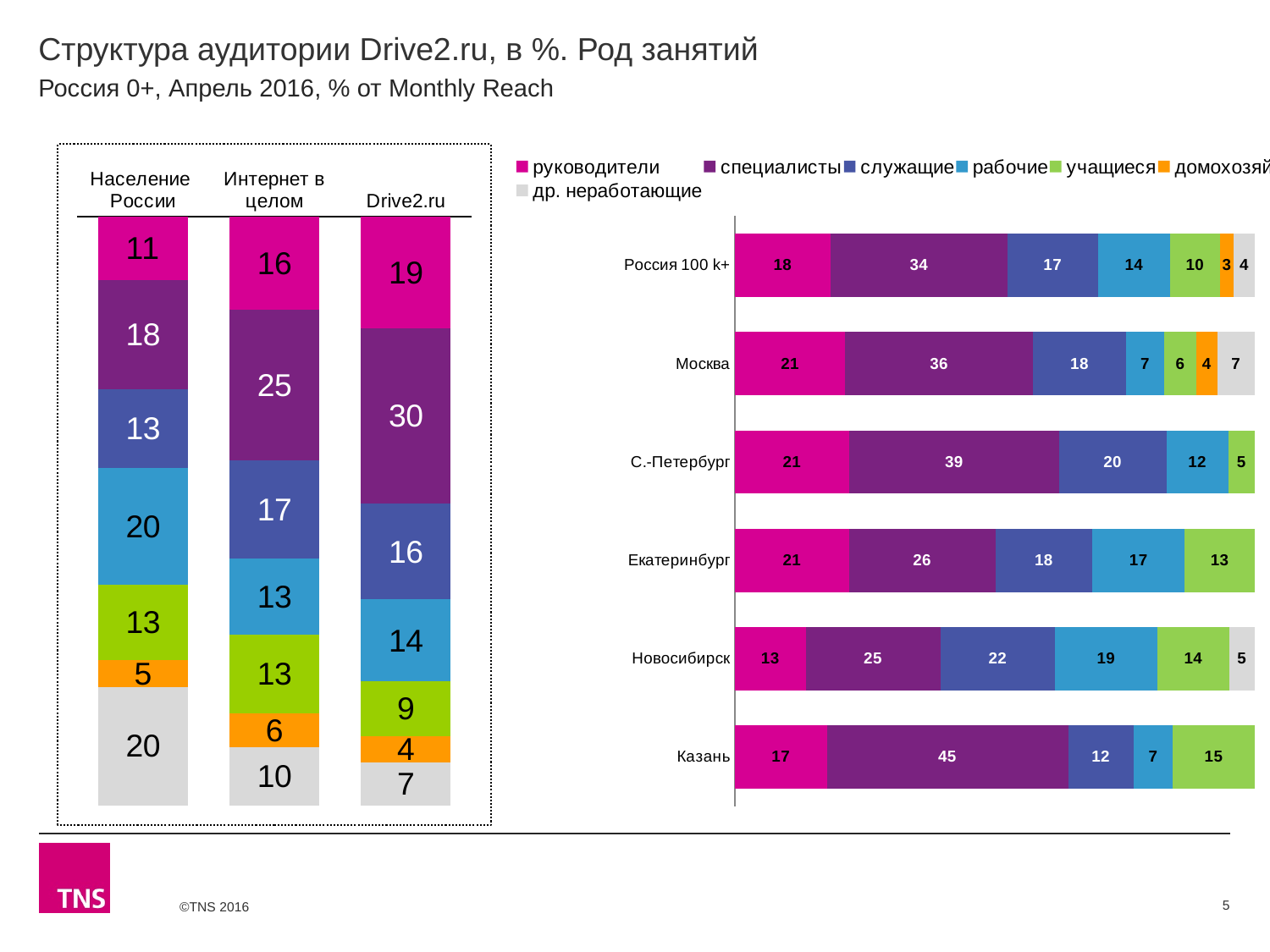
In the right chart, which category has the lowest value for руководители? Новосибирск What type of chart is the right chart? Stacked bar chart In the left chart, what is the value for рабочие in the Население России bar? 20 How many categories are shown on the x axis of the left chart? 3 In the left chart, what is the difference between the руководители values for Drive2.ru and Население России? 8 In the right chart, which is larger: the рабочие value for Екатеринбург or for Москва? Екатеринбург In the left chart, what is the value for специалисты in the Drive2.ru bar? 30 How many cities/regions are listed in the right chart? 6 How many series does the legend list? 7 In the right chart, what is the value for служащие for Новосибирск? 22 In the right chart, which city has the highest value for специалисты? Казань In the right chart, what is the value for специалисты for Казань? 45